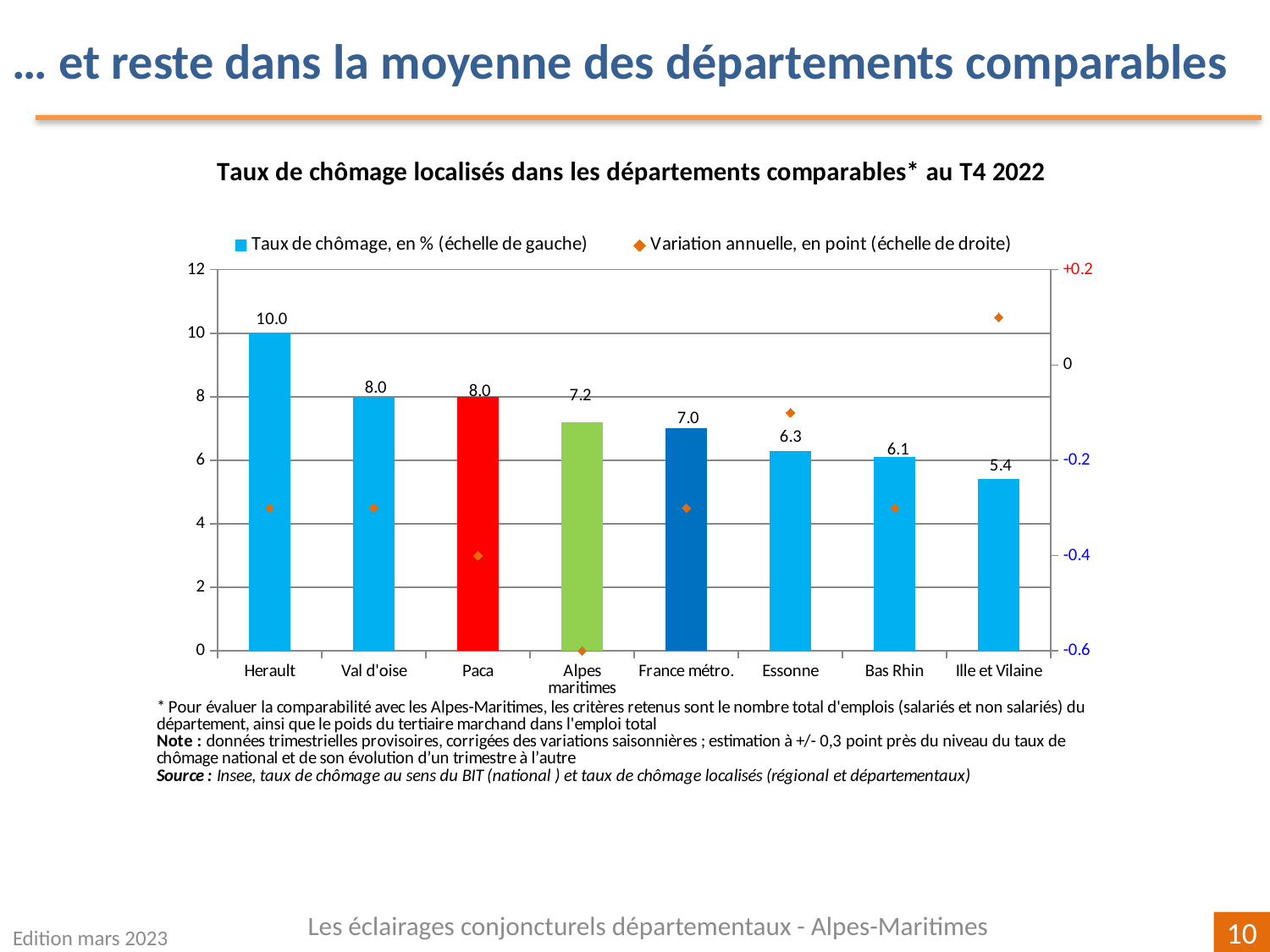
Which category has the highest unemployment rate bar? Herault What is the unemployment rate (Taux de chômage) shown for Herault? 10.0 What is the unemployment rate shown for Alpes maritimes? 7.2 Which category has the lowest unemployment rate bar? Ille et Vilaine What type of chart is used to show the unemployment rates? Bar chart How many series does the chart legend list? 2 Is the annual variation (Variation annuelle) for Paca greater or less than -0.2? less What is the difference between the unemployment rate of Herault and that of France métro.? 3.0 How many categories are shown on the x axis of the chart? 8 What is the unemployment rate shown for Ille et Vilaine? 5.4 Is the annual variation (Variation annuelle) for Ille et Vilaine greater or less than 0? greater Which has a higher unemployment rate, Essonne or Bas Rhin? Essonne